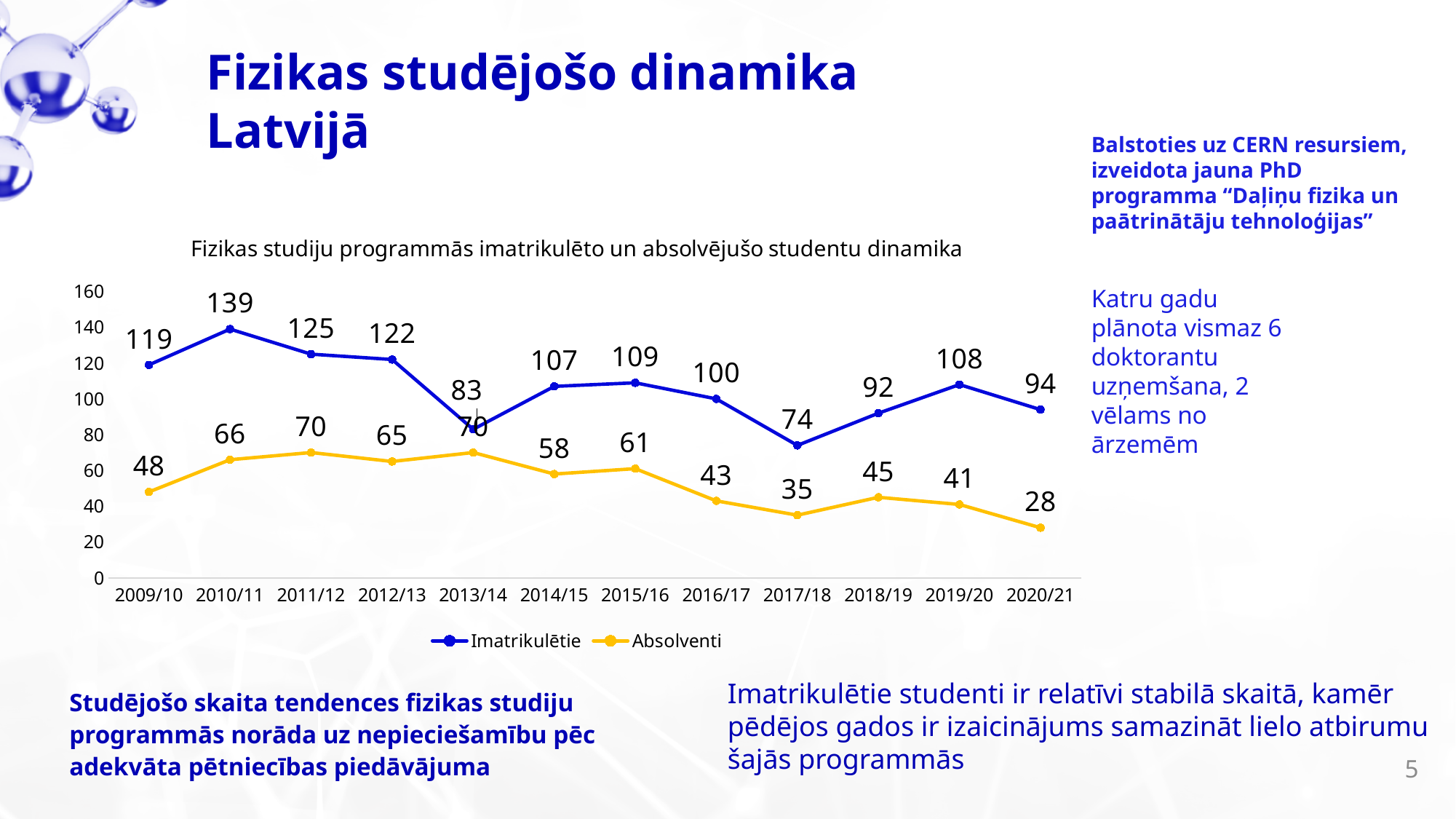
What is the value for Absolventi in 2020/21? 28 In which year is the Absolventi value the lowest? 2020/21 In which year is the Imatrikulētie value the lowest? 2017/18 Which is larger: the Absolventi value in 2011/12 or in 2016/17? 2011/12 What is the difference between the Imatrikulētie values in 2010/11 and 2017/18? 65 What is the value for Absolventi in 2013/14? 70 How many series does the legend list? 2 What is the value for Imatrikulētie in 2010/11? 139 In which year is the Imatrikulētie value the highest? 2010/11 What kind of chart is shown on the slide? Line chart What is the difference between Imatrikulētie and Absolventi in 2020/21? 66 How many academic years are shown on the x axis? 12